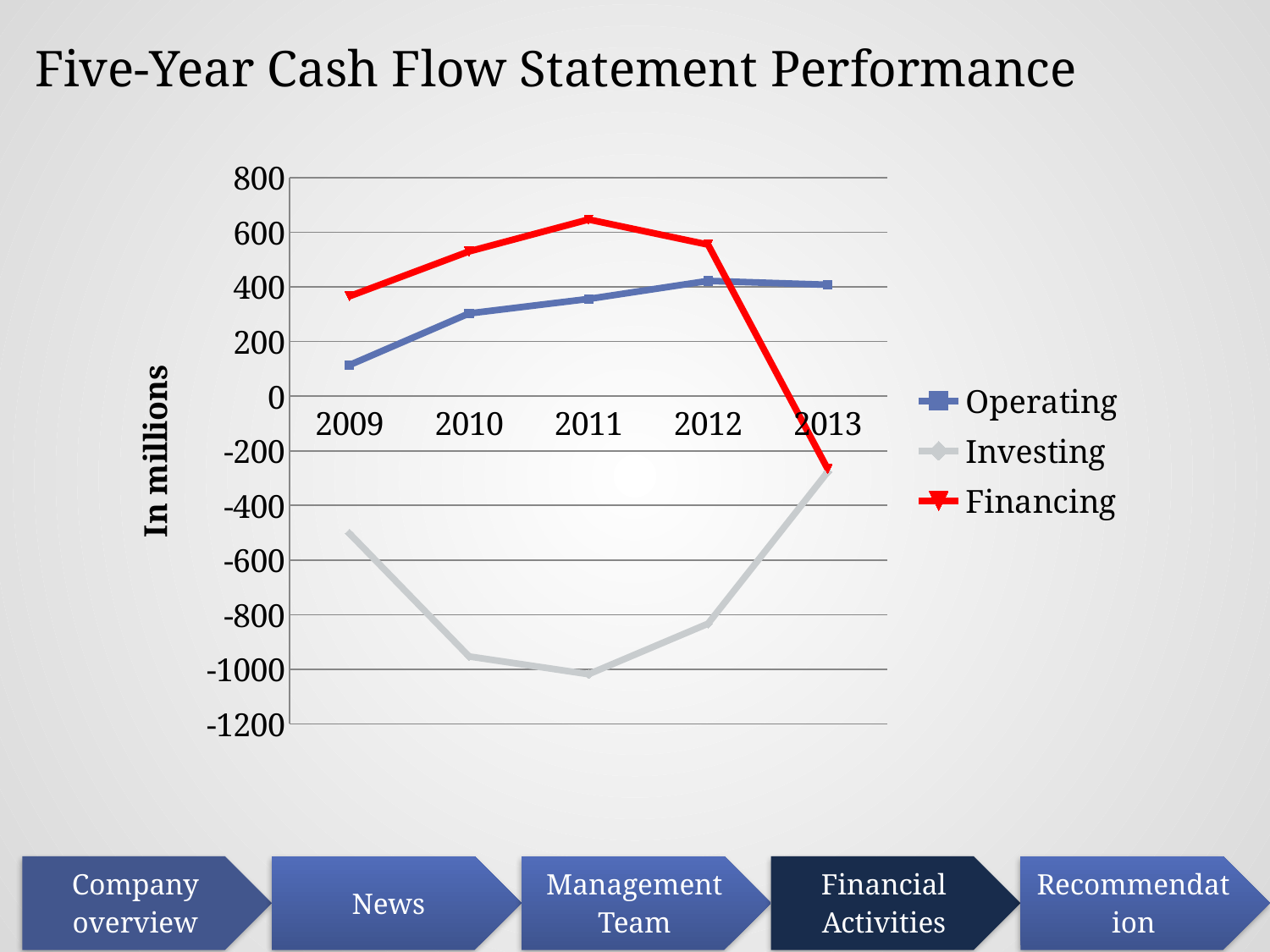
Does the Operating series rise or fall from 2009 to 2012? rise In 2010, which is larger, the Operating value or the Financing value? Financing Is the Financing value for 2011 greater or less than 600? greater What is the label on the vertical axis? In millions Does the Financing series rise or fall from 2012 to 2013? fall How many series does the legend list? 3 How many years are plotted along the x axis? 5 In which year does the Investing series reach its lowest value? 2011 What kind of chart is shown on the slide? line chart Is the Operating value for 2009 greater or less than 200? less Is the Investing value for 2010 greater or less than -800? less In which year does the Financing series reach its highest value? 2011